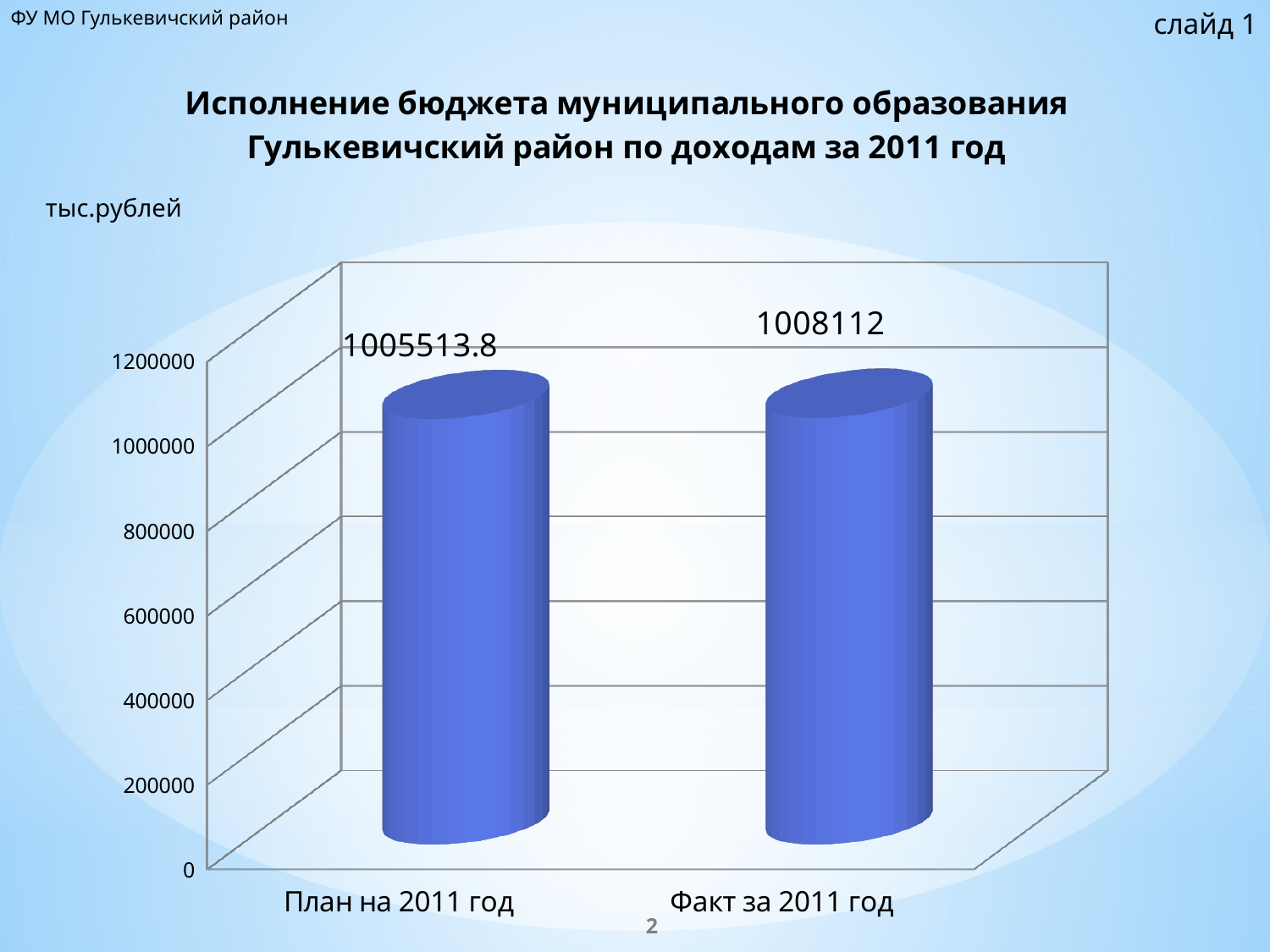
What is the value for Факт за 2011 год? 1008112 Which category has the lowest value? План на 2011 год What is the difference between the value for Факт за 2011 год and the value for План на 2011 год? 2598.2 Is the value for Факт за 2011 год greater or less than 1200000? less Which category has the higher value, План на 2011 год or Факт за 2011 год? Факт за 2011 год What kind of chart is shown on the slide? bar chart How many categories are shown on the chart? 2 What unit of measurement is indicated for the chart values? тыс.рублей Which category has the highest value? Факт за 2011 год Is the value for План на 2011 год greater or less than 1000000? greater What is the value for План на 2011 год? 1005513.8 What is the title of the chart? Исполнение бюджета муниципального образования Гулькевичский район по доходам за 2011 год